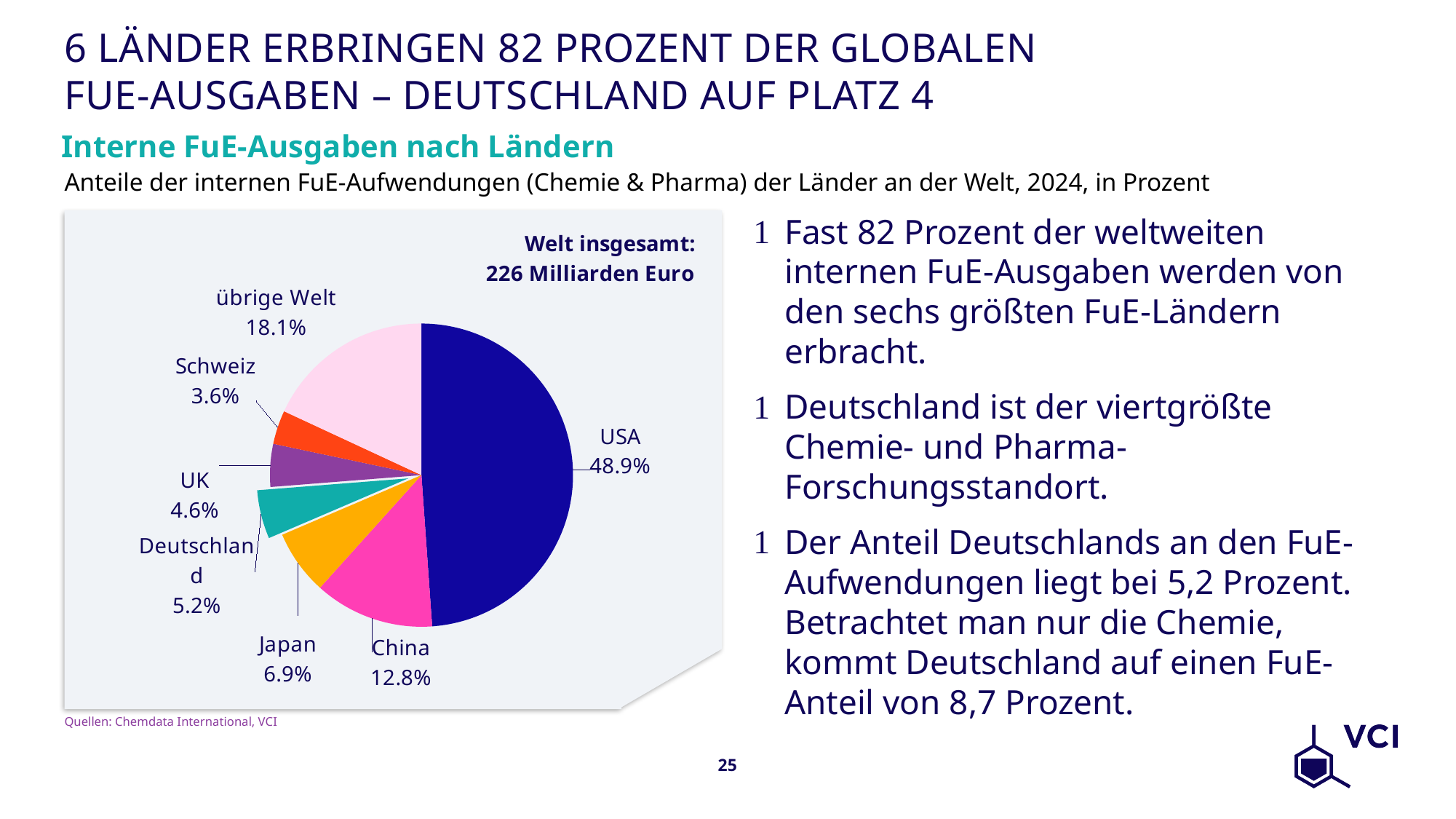
What is the value shown for China? 12.8% What is the difference between the shares of USA and China? 36.1% How many slices does the pie chart have? 7 What share of the pie does USA hold? 48.9% What is the value shown for Deutschland? 5.2% What is the difference between the shares of Japan and UK? 2.3% What kind of chart is shown on the slide? Pie chart Which category has the smallest slice of the pie? Schweiz Which category has the largest slice of the pie? USA Which is larger, the share of Japan or the share of Deutschland? Japan What is the value shown for Schweiz? 3.6% What total value for the world is stated in the chart? 226 Milliarden Euro